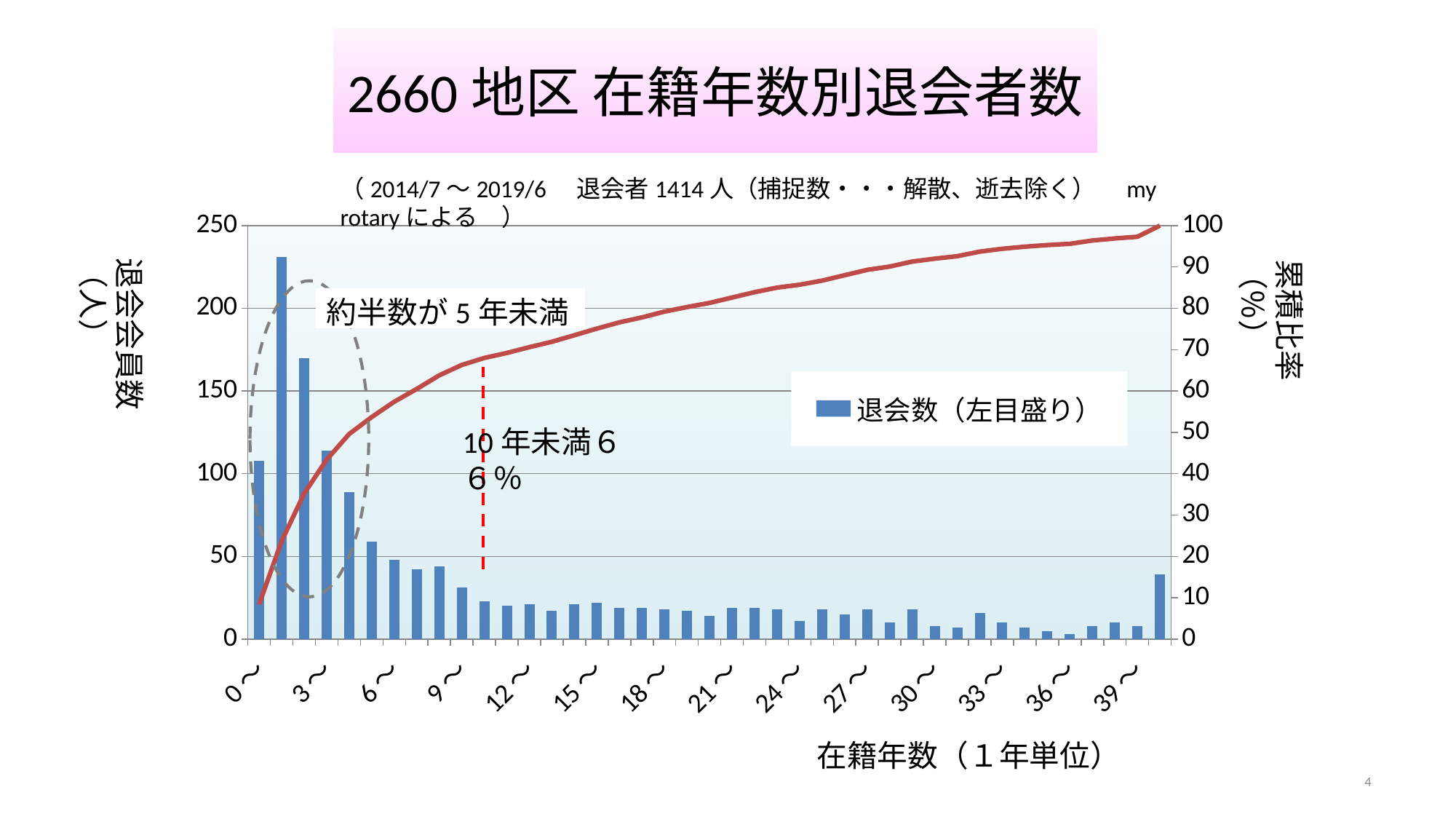
Which has the larger bar, 0～ or 6～? 0～ Which has the larger bar, 3～ or 9～? 3～ What kind of chart is shown on the slide? bar chart with a line Does the cumulative line (right axis) rise or fall along the x axis? rise Is the bar value for 0～ greater or less than 150? less Is the bar value for 3～ greater or less than 150? less What is the title of the slide's chart? 2660 地区 在籍年数別退会者数 How many series does the legend list? 1 Is the bar value for 9～ greater or less than 50? less What is the legend entry shown on the chart? 退会数（左目盛り）